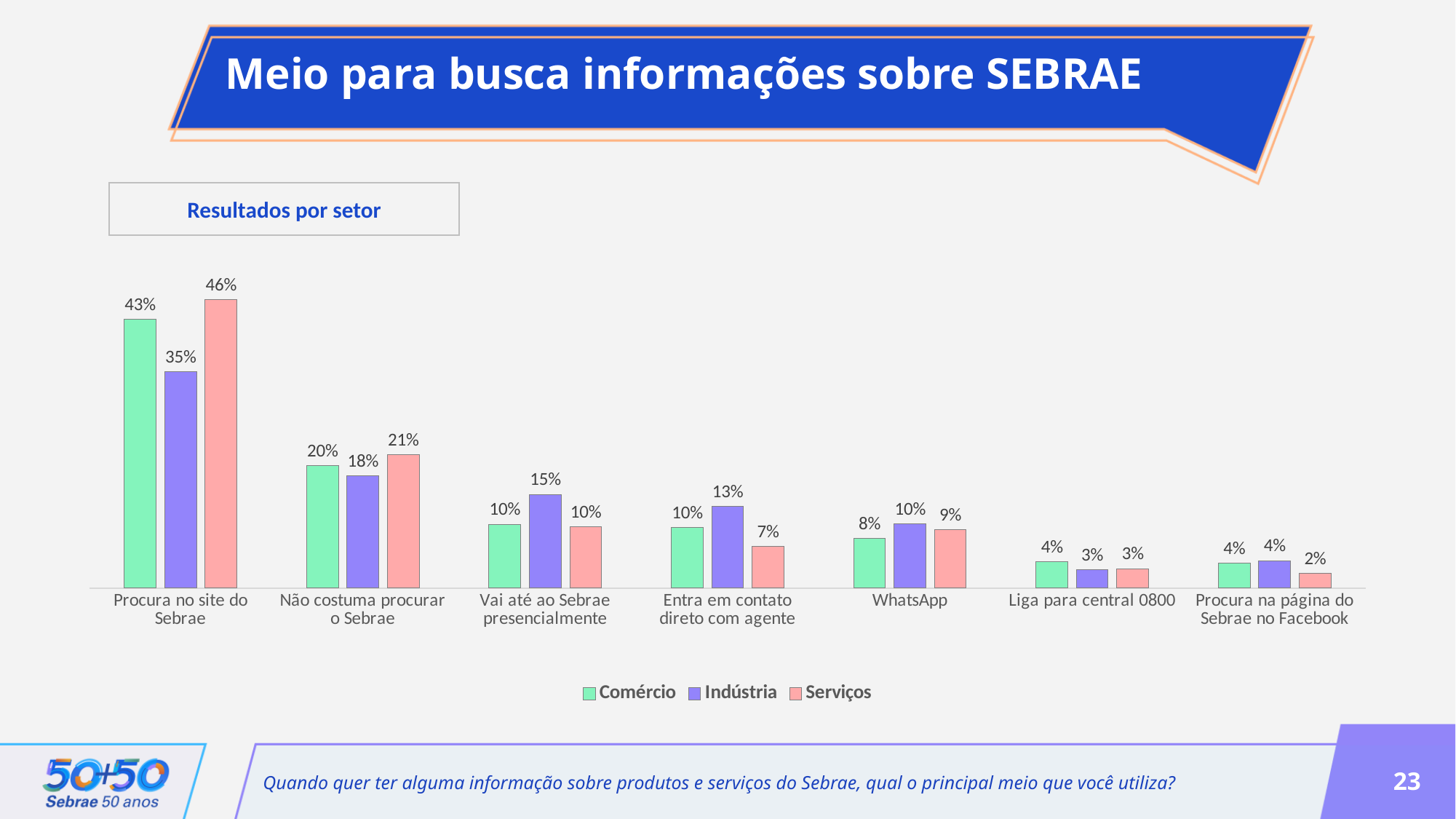
How many categories are shown on the x axis? 7 What is the Indústria value for 'Vai até ao Sebrae presencialmente'? 15% What is the difference between the Serviços and Indústria values for 'Procura no site do Sebrae'? 11% For 'Não costuma procurar o Sebrae', which is larger: Comércio or Indústria? Comércio Which category has the lowest Serviços value? Procura na página do Sebrae no Facebook Which series is shown in purple in the legend? Indústria What is the Serviços value for 'Procura no site do Sebrae'? 46% Which category has the highest Indústria value? Procura no site do Sebrae How many series does the legend list? 3 What is the difference between the Indústria and Serviços values for 'Entra em contato direto com agente'? 6% What kind of chart is shown on the slide? Bar chart What is the Comércio value for 'WhatsApp'? 8%